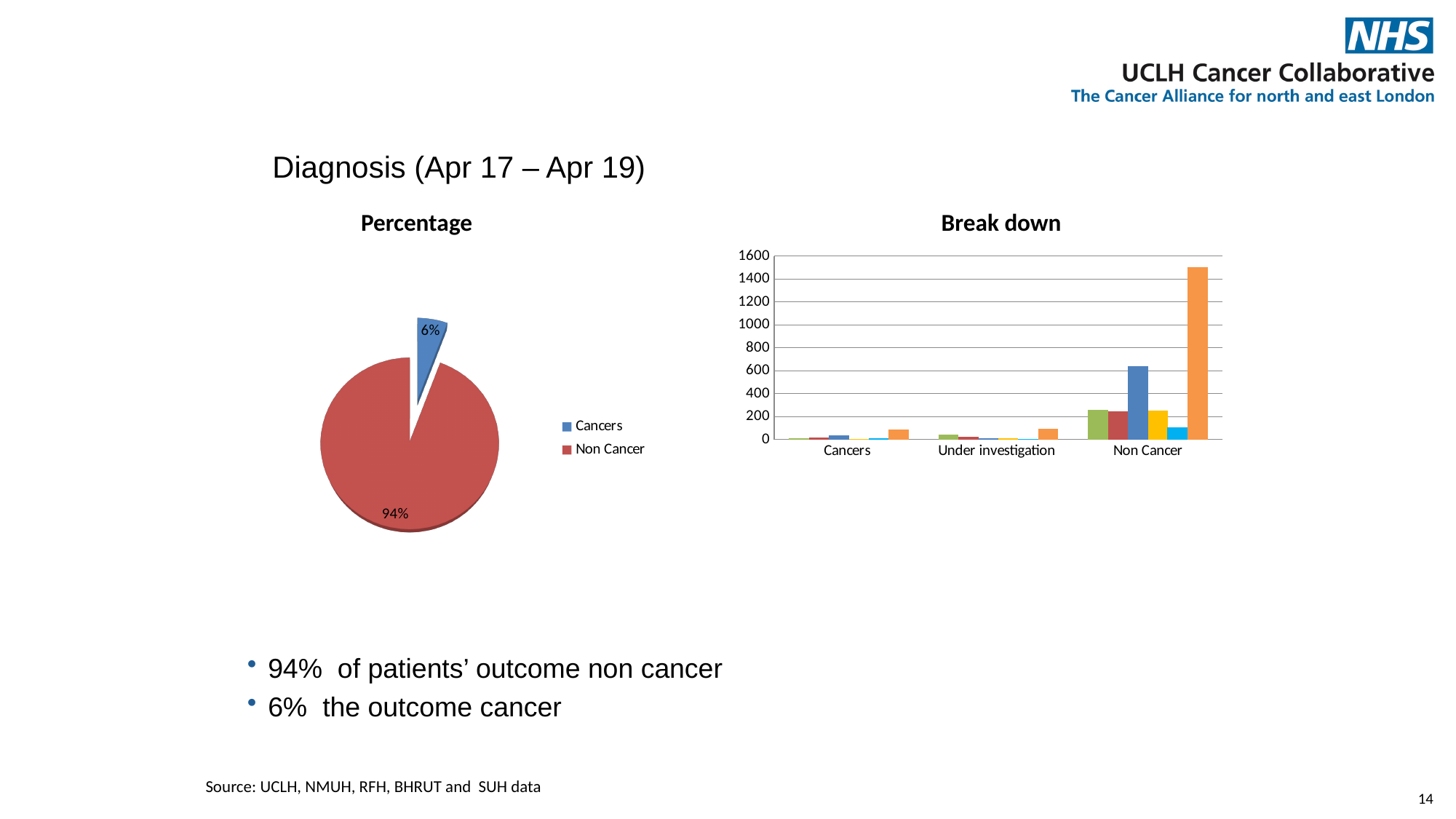
How many entries does the legend of the Percentage chart list? 2 In the Break down chart, is the value of the tallest (orange) bar for Non Cancer greater or less than 1400? greater What kind of chart is the chart titled Percentage? Pie chart In the Percentage pie chart, which slice is the smallest? Cancers In the Percentage pie chart, what share is shown for Non Cancer? 94% What kind of chart is the chart titled Break down? Bar chart In the Percentage pie chart, which slice is the largest? Non Cancer In the Percentage pie chart, how many percentage points larger is the Non Cancer slice than the Cancers slice? 88 In the Break down chart, which category contains the tallest bar? Non Cancer In the Break down chart, is the value of the dark blue bar for Non Cancer greater or less than 400? greater In the Percentage pie chart, what share is shown for Cancers? 6% How many categories are shown on the x axis of the Break down chart? 3